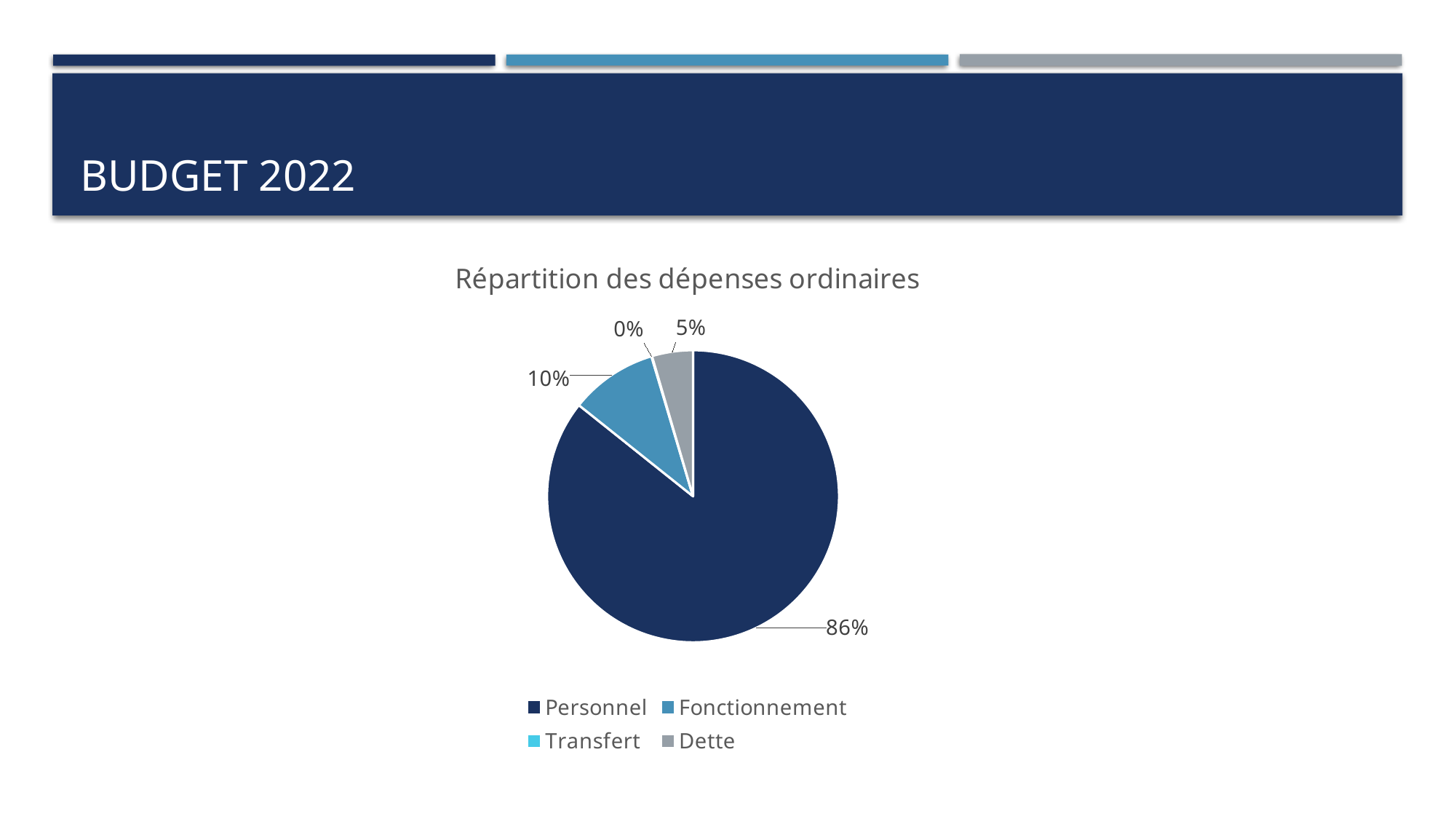
What colour is the Dette slice? grey Which category has the largest slice of the pie? Personnel What share of the pie does Dette represent? 5% What is the title of the chart? Répartition des dépenses ordinaires What share of the pie does Transfert represent? 0% How many categories does the legend list? 4 What share of the pie does Fonctionnement represent? 10% Which is larger, the share for Fonctionnement or the share for Dette? Fonctionnement What is the difference in percentage points between Personnel and Fonctionnement? 76 What type of chart is shown on the slide? pie chart Which category has the smallest slice of the pie? Transfert What share of the pie does Personnel represent? 86%